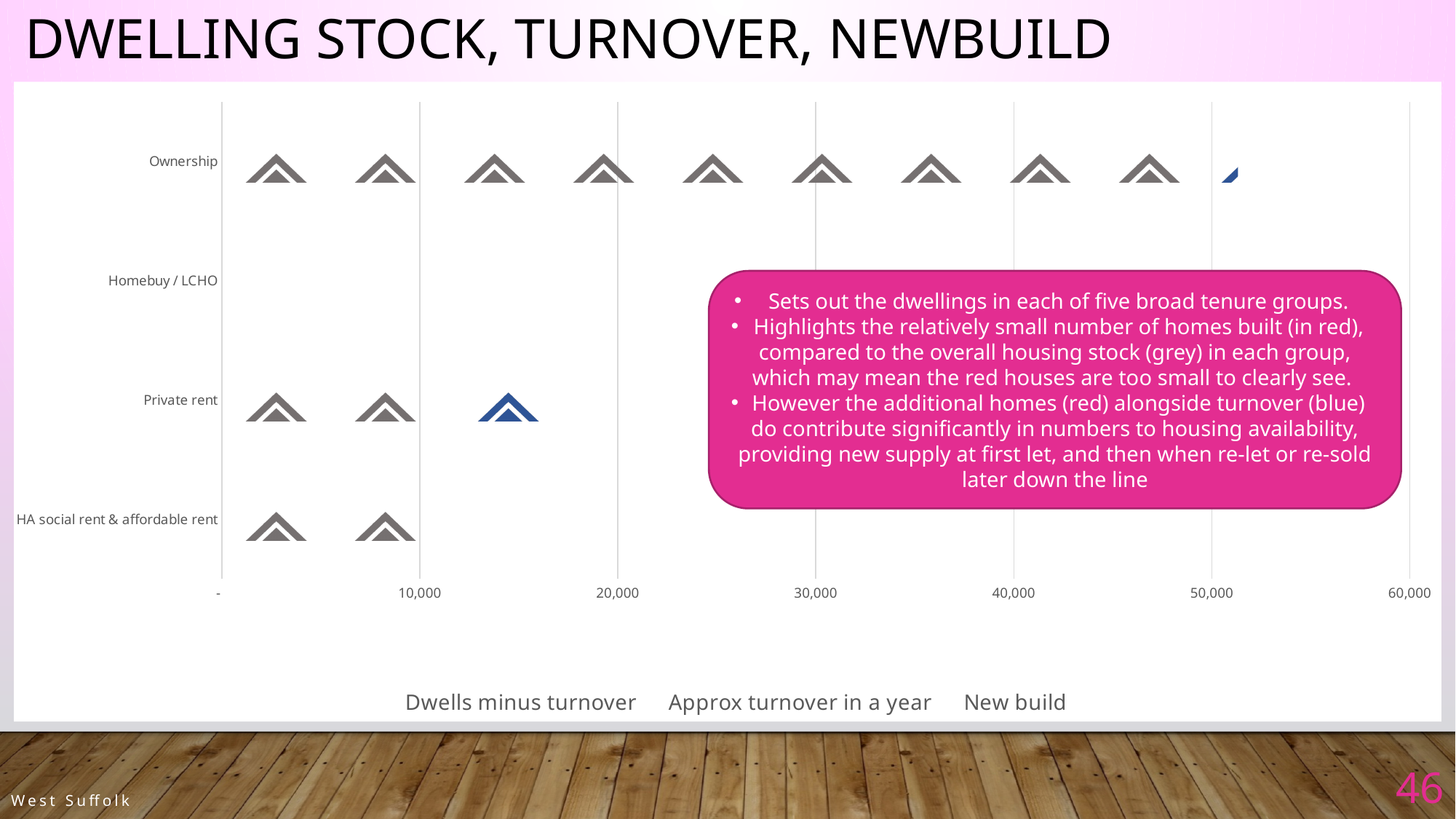
Is the total value for HA social rent & affordable rent greater or less than 20,000? less What kind of chart is shown on the slide? bar chart Which category has the highest total value in the chart? Ownership Is the total value for Private rent greater or less than 20,000? less How many tenure categories are listed on the vertical axis of the chart? 4 Which is larger, the total for Ownership or the total for Private rent? Ownership How many series does the chart legend list? 3 Which is larger, the total for Private rent or the total for HA social rent & affordable rent? Private rent Which category has the lowest total value in the chart? Homebuy / LCHO Is the total value for Private rent greater or less than 10,000? greater What are the three series named in the chart legend? Dwells minus turnover, Approx turnover in a year, New build